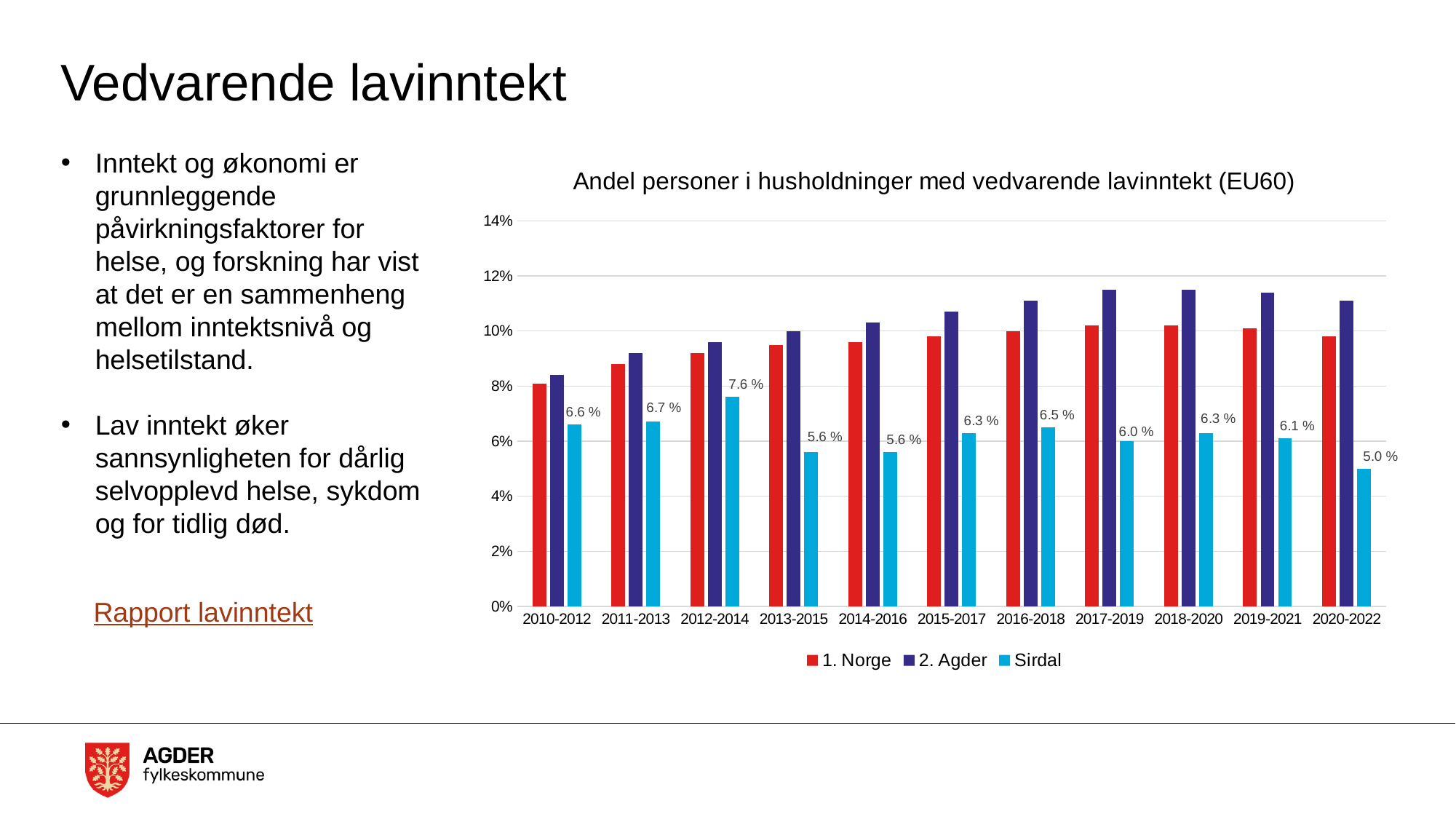
What is the value for Sirdal in 2016-2018? 6.5 % In which period is the Sirdal value highest? 2012-2014 What is the value for Sirdal in 2012-2014? 7.6 % In which period is the Sirdal value lowest? 2020-2022 What is the difference between the Sirdal values for 2012-2014 and 2020-2022? 2.6 percentage points What is the value for Sirdal in 2020-2022? 5.0 % In 2020-2022, which is larger: the value for 1. Norge or for 2. Agder? 2. Agder What is the title of the chart? Andel personer i husholdninger med vedvarende lavinntekt (EU60) How many series does the legend list? 3 How many periods are shown on the x axis? 11 Is the value for 2. Agder in 2017-2019 greater or less than 10%? greater What kind of chart is shown on the slide? Bar chart